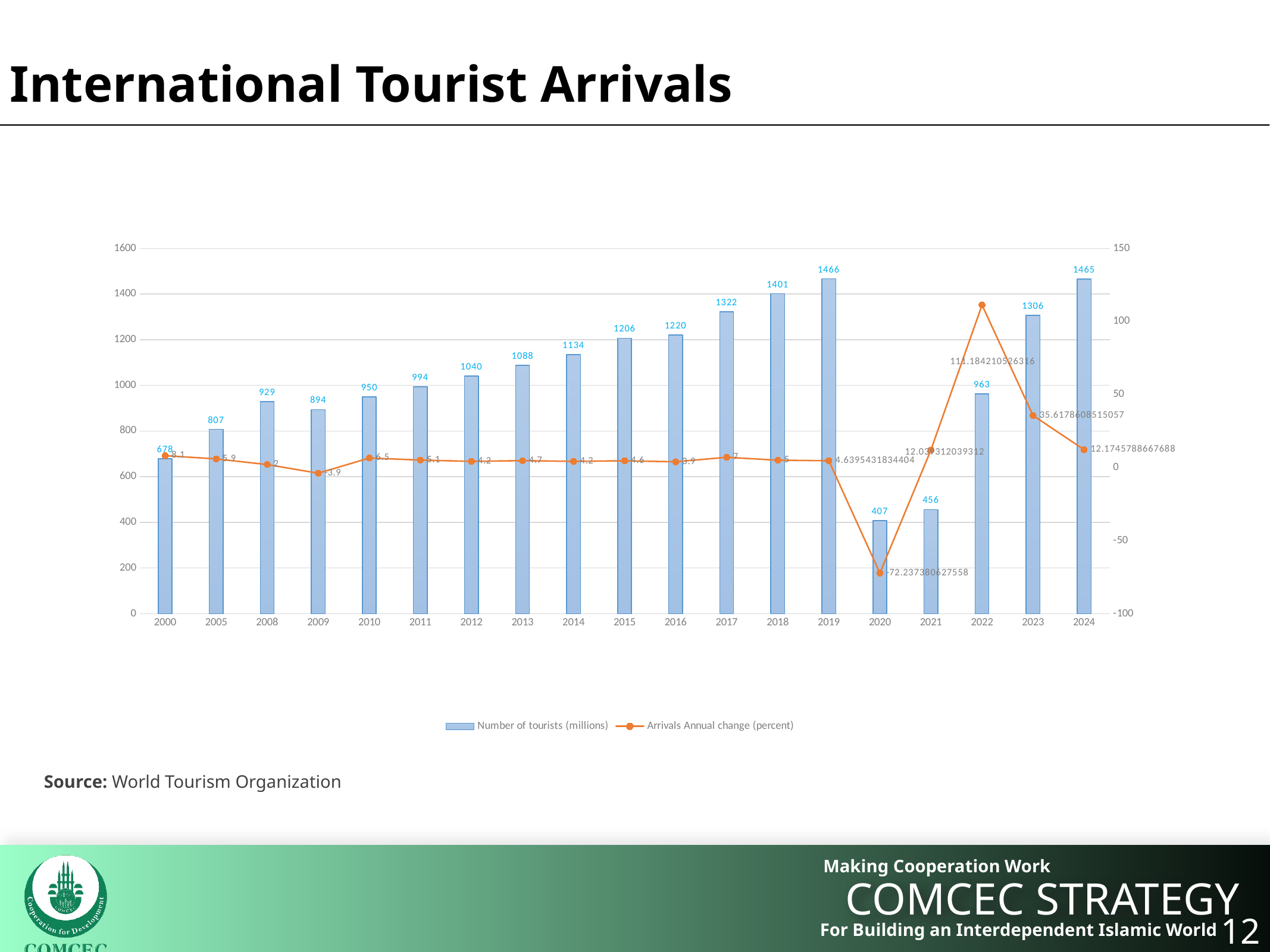
Which year has the highest arrivals annual change (percent)? 2022 Which year has the lowest number of tourists (millions)? 2020 What is the number of tourists (millions) for 2019? 1466 What is the number of tourists (millions) for 2020? 407 How many years are shown on the x axis? 19 What kind of chart is shown on the slide? A combination bar and line chart What is the number of tourists (millions) for 2024? 1465 How many series does the legend list? 2 Which year has more tourists (millions), 2021 or 2022? 2022 Do the number of tourists (millions) rise or fall from 2000 to 2019? Rise What is the difference in number of tourists (millions) between 2019 and 2020? 1059 What is the arrivals annual change (percent) for 2009? -3.9